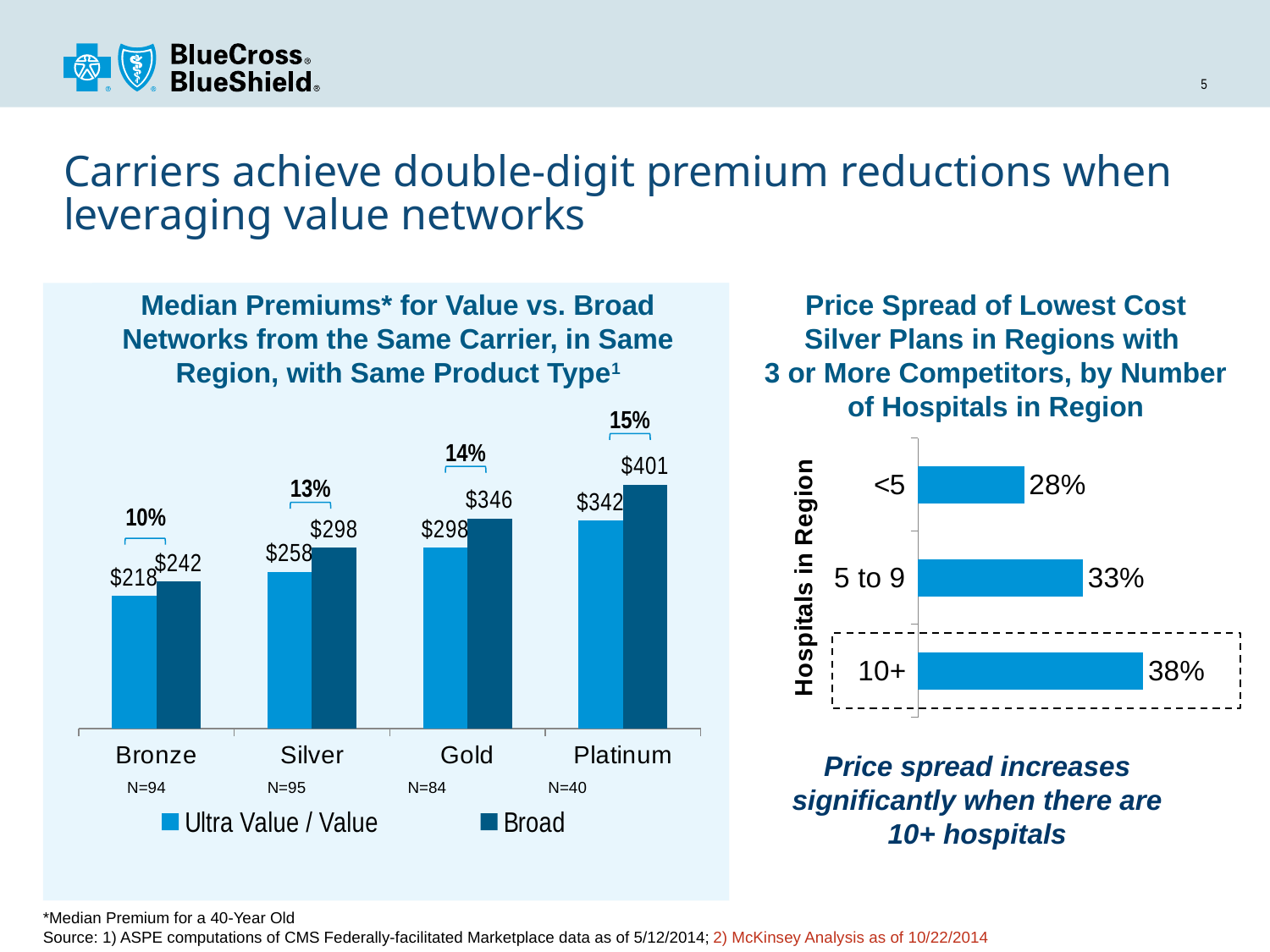
In the Median Premiums chart, how many series does the legend list? 2 In the Median Premiums chart, what is the Broad network median premium for Gold? $346 In the Price Spread chart, what is the difference in price spread between 10+ hospitals and <5 hospitals? 10% In the Median Premiums chart, what is the Ultra Value / Value median premium for Bronze? $218 In the Median Premiums chart, which product type has the lowest Ultra Value / Value median premium? Bronze In the Median Premiums chart, which product type has the highest Broad median premium? Platinum In the Price Spread chart, which hospital category has the lowest price spread? <5 In the Median Premiums chart, what is the difference between the Broad and Ultra Value / Value premiums for Silver? $40 What kind of chart is the Price Spread of Lowest Cost Silver Plans chart? Bar chart In the Median Premiums chart, what is the Broad median premium for Platinum? $401 In the Price Spread chart, what is the price spread for regions with 10+ hospitals? 38% In the Median Premiums chart, what percentage reduction is shown above the Gold bars? 14%